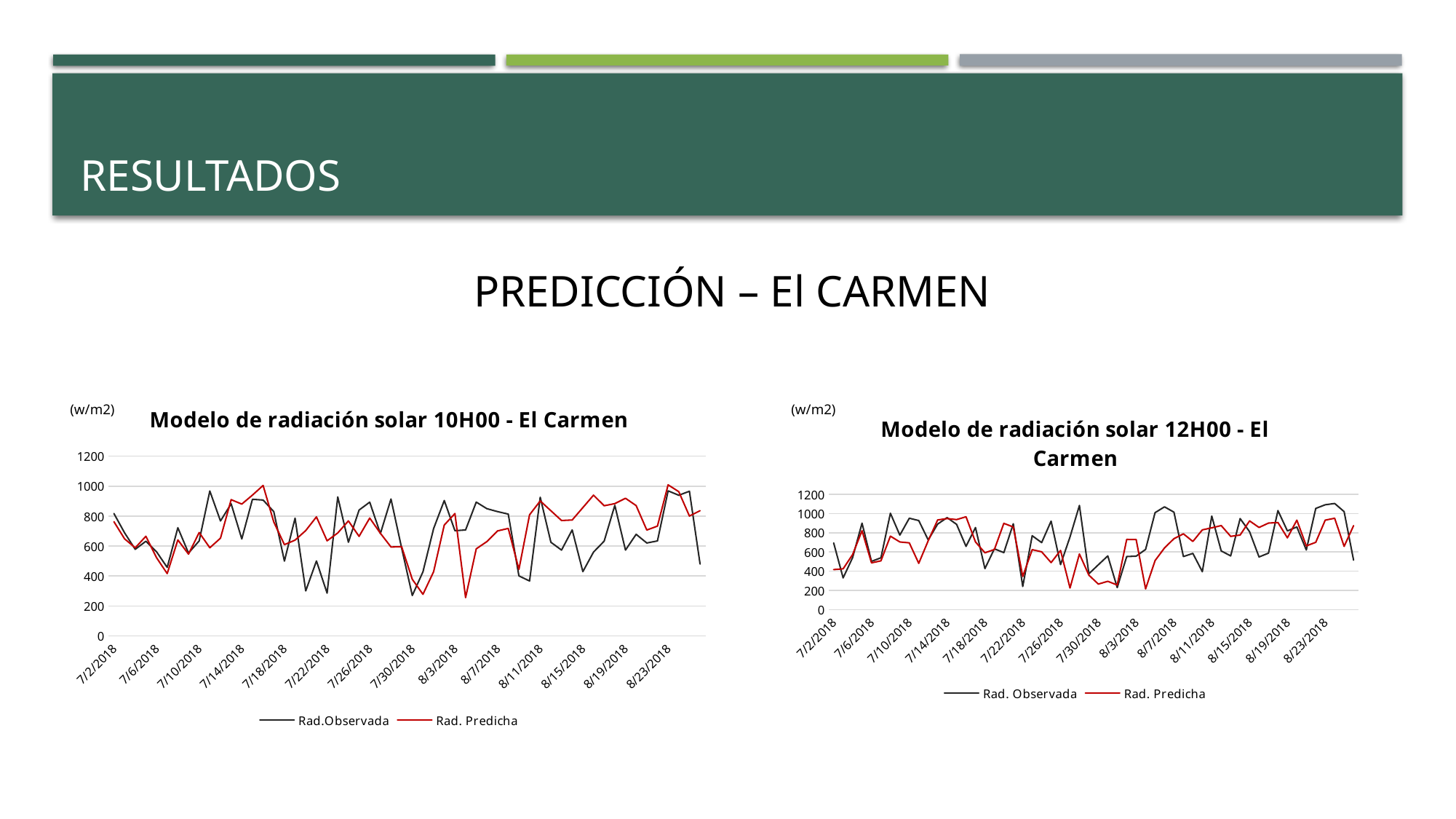
How many date labels are shown on the x axis of the left chart (10H00)? 14 How many series does the legend of the left chart (10H00) list? 2 What kind of chart is the left chart titled 'Modelo de radiación solar 10H00 - El Carmen'? line chart In the right chart (12H00), is the value of Rad. Observada on 7/2/2018 greater or less than 400? greater What kind of chart is the right chart titled 'Modelo de radiación solar 12H00 - El Carmen'? line chart What unit is shown above the y axis of the right chart (12H00)? (w/m2) In the right chart (12H00), is the value of Rad. Predicha on 8/3/2018 greater or less than 400? greater In the left chart (10H00), is the value of Rad. Predicha on 7/18/2018 greater or less than 800? less In the left chart (10H00), which series is drawn in red? Rad. Predicha How many series does the legend of the right chart (12H00) list? 2